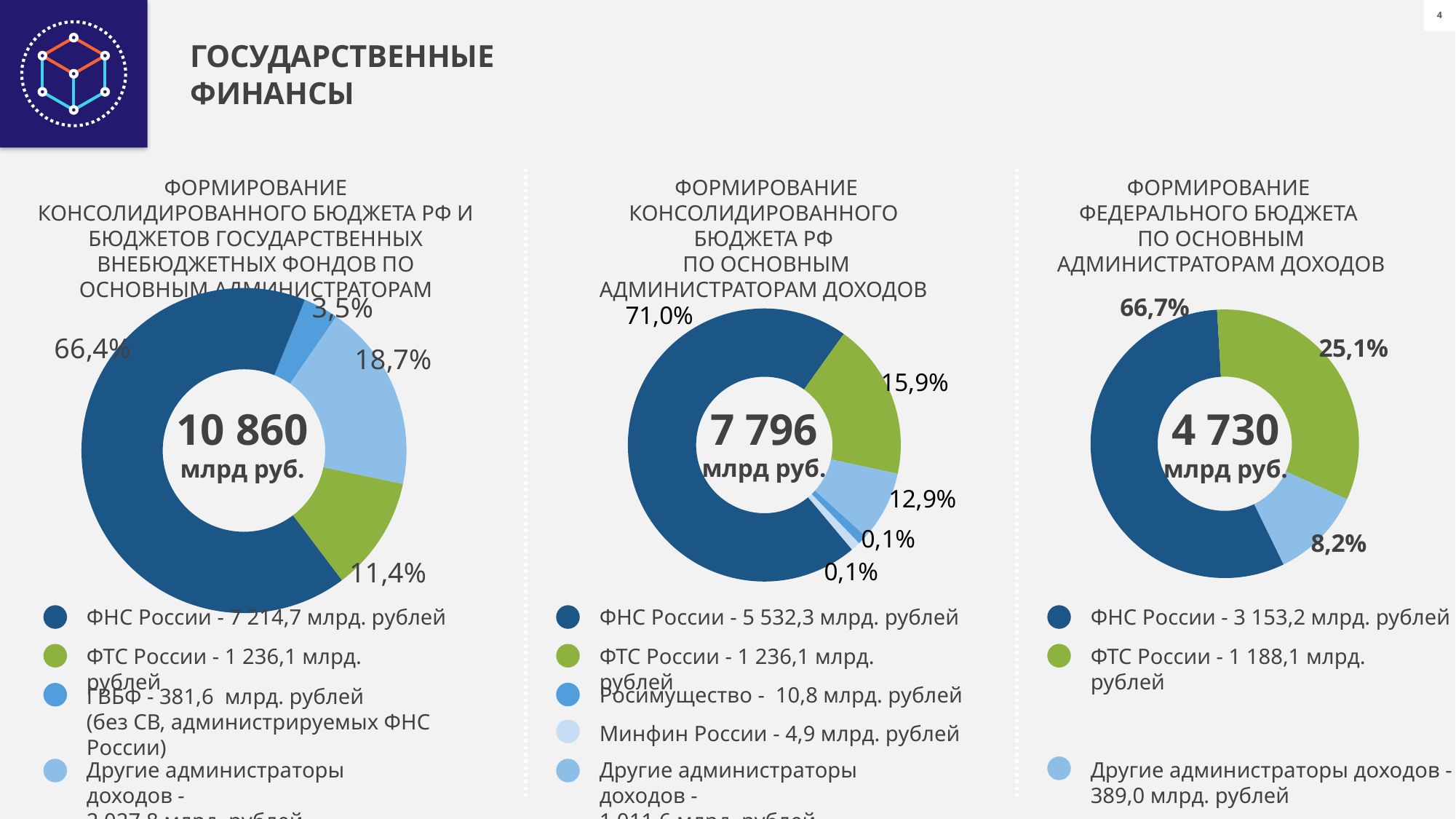
On the middle chart, what amount does the legend give for Росимущество? 10,8 млрд. рублей On the left chart, which administrator has the smallest share? ГВБФ On the middle chart, what share is attributed to ФНС России? 71,0% On the middle chart, what is the difference in percentage points between the ФТС России share and the Другие администраторы доходов share? 3,0% On the right chart, which is larger: the amount for ФТС России or for Другие администраторы доходов? ФТС России On the left chart, what share of the consolidated budget and state extra-budgetary funds is attributed to ФНС России? 66,4% On the right chart, what is the total value shown in the centre of the donut? 4 730 млрд руб. What kind of chart is used on the right of the slide? Donut (pie) chart On the left chart, what is the total value shown in the centre of the donut? 10 860 млрд руб. On the right chart, what share is attributed to ФТС России? 25,1% On the left chart, what amount does the legend give for ФТС России? 1 236,1 млрд. рублей On the middle chart, how many categories does the legend list? 5